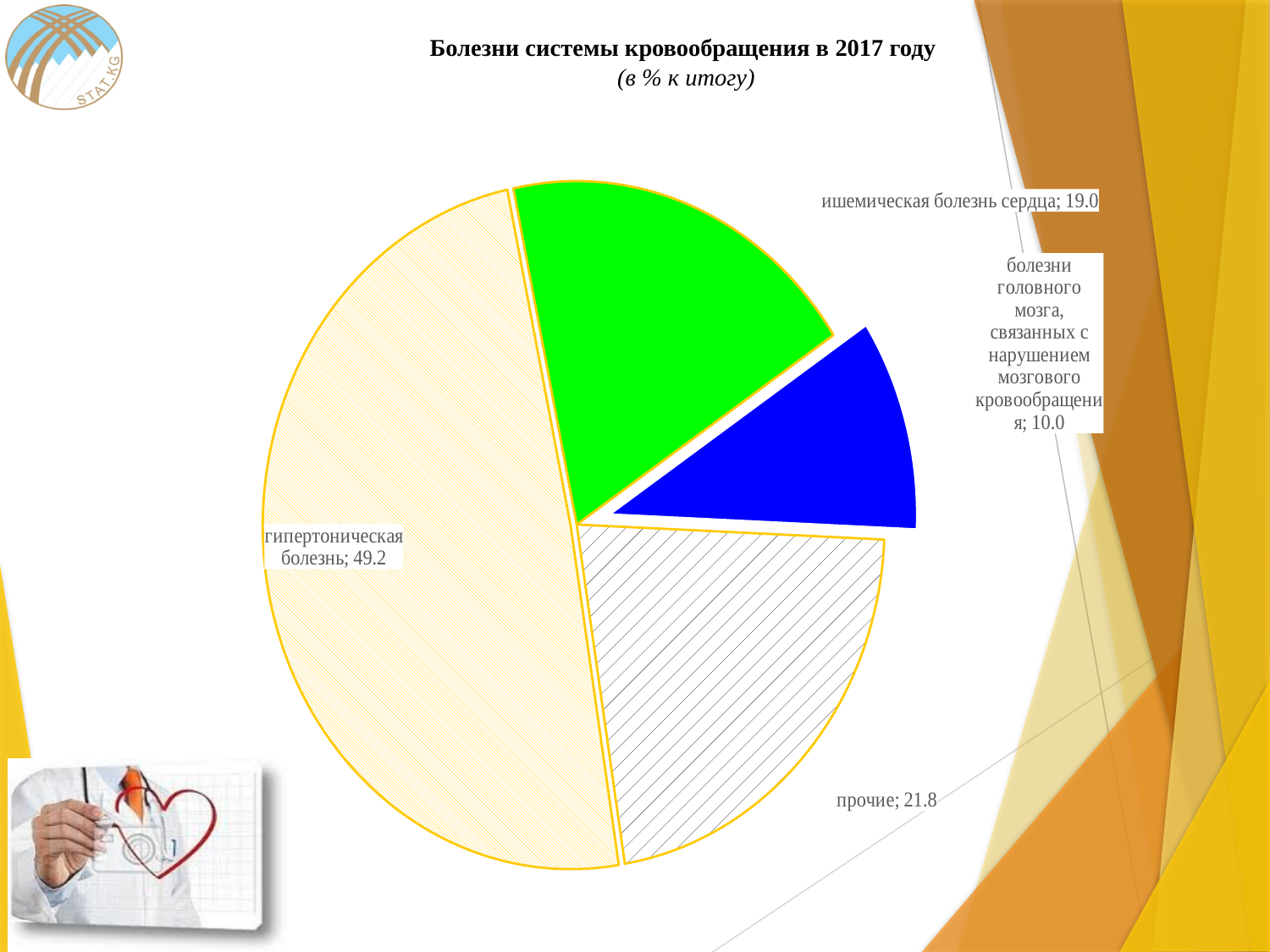
Which category has the smallest share of the pie? болезни головного мозга, связанных с нарушением мозгового кровообращения What is the difference between the values for ишемическая болезнь сердца and болезни головного мозга, связанных с нарушением мозгового кровообращения? 9.0 What is the title of the chart? Болезни системы кровообращения в 2017 году (в % к итогу) What is the value for ишемическая болезнь сердца? 19.0 Which category has the largest share of the pie? гипертоническая болезнь What is the value for прочие? 21.8 What kind of chart is shown on the slide? pie chart What is the value for гипертоническая болезнь? 49.2 What is the value for болезни головного мозга, связанных с нарушением мозгового кровообращения? 10.0 What is the difference between the values for гипертоническая болезнь and прочие? 27.4 How many slices does the pie chart have? 4 Which is larger, the value for прочие or the value for ишемическая болезнь сердца? прочие